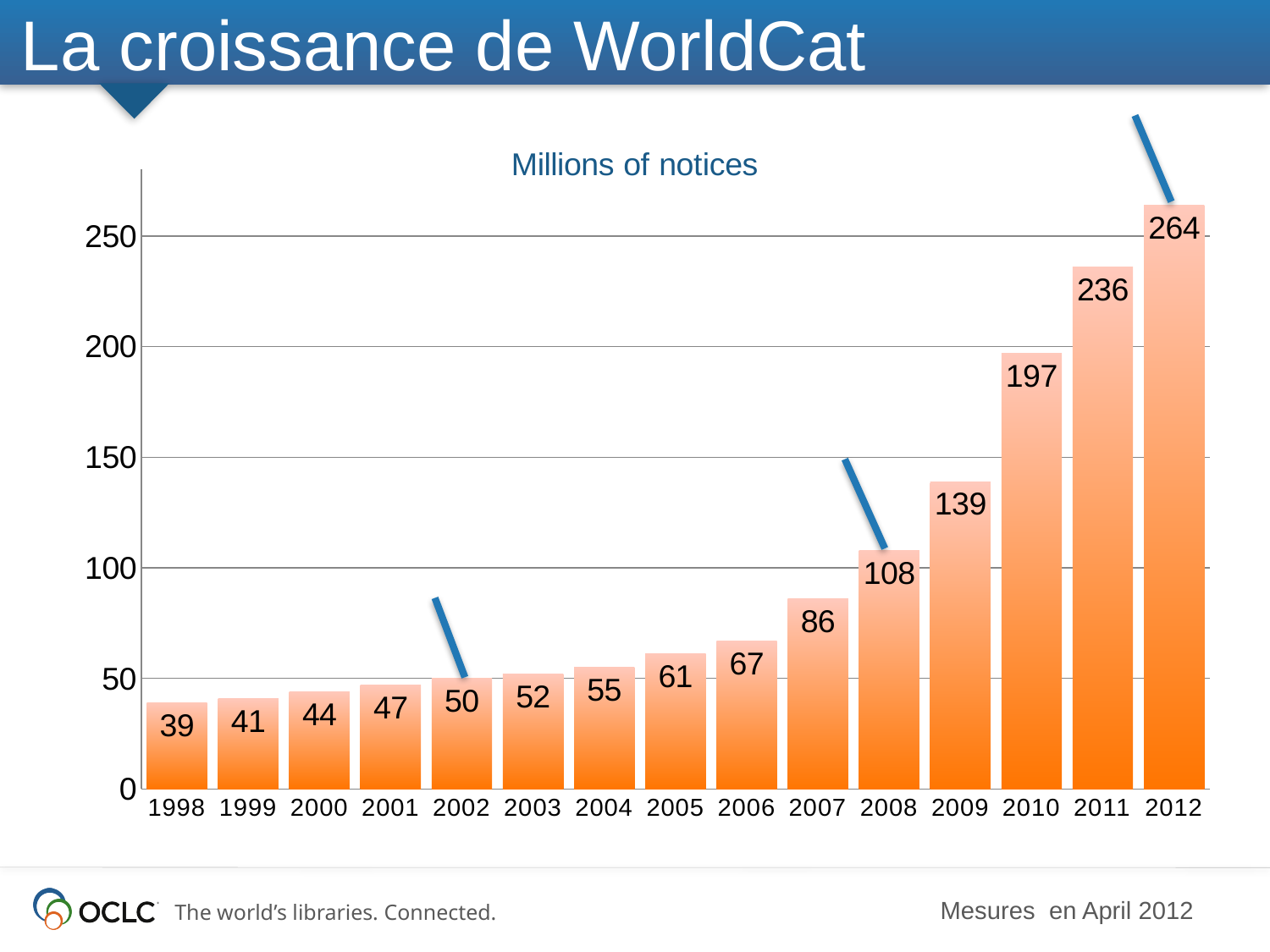
Which year has the lowest value? 1998 What is the difference between the values for 2012 and 2011? 28 Which is larger, the value for 2007 or the value for 2006? 2007 What is the difference between the values for 2009 and 2008? 31 Is the value for 2011 greater or less than 200? greater What is the value for 2008? 108 What is the value for 2010? 197 What kind of chart is shown on the slide? bar chart How many years are shown on the x axis? 15 Which year has the highest value? 2012 Do the values rise or fall from 1998 to 2012? rise What is the value for 1998? 39